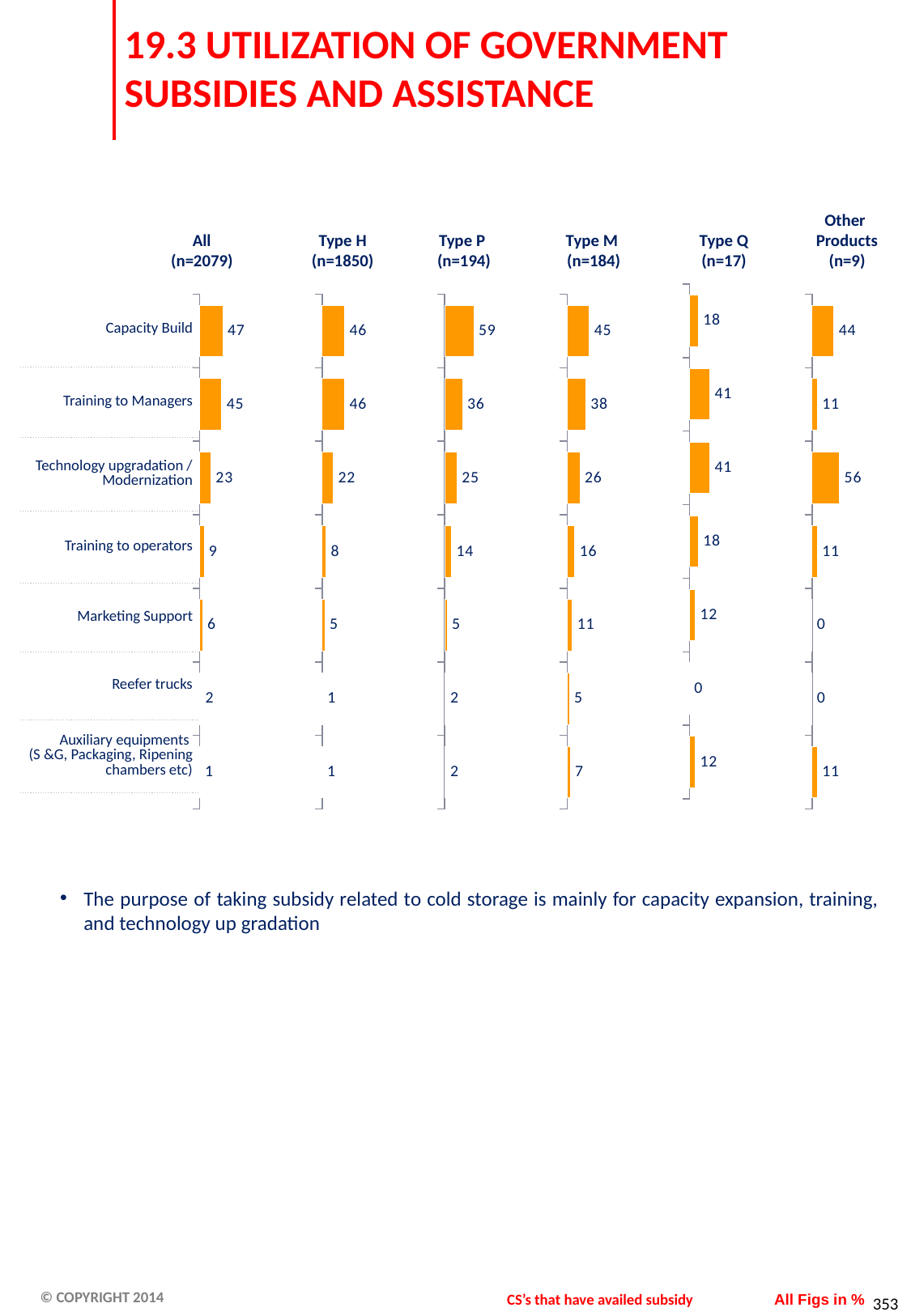
In the 'Type P (n=194)' chart, what is the difference between Capacity Build and Training to operators? 45 In the 'Type M (n=184)' chart, which category has the lowest value? Reefer trucks In the 'Type P (n=194)' chart, what is the value for Training to Managers? 36 In the 'Type H (n=1850)' chart, what is the difference between Capacity Build and Technology upgradation / Modernization? 24 In the 'Other Products (n=9)' chart, what is the value for Marketing Support? 0 In the 'All (n=2079)' chart, what is the value for Capacity Build? 47 In the 'Type M (n=184)' chart, what is the value for Auxiliary equipments (S &G, Packaging, Ripening chambers etc)? 7 What type of chart is used for the 'All (n=2079)' column? Bar chart In the 'Other Products (n=9)' chart, which category has the highest value? Technology upgradation / Modernization In the 'Type Q (n=17)' chart, which is larger: Training to Managers or Capacity Build? Training to Managers How many separate bar charts are shown on the slide? 6 How many categories are shown in each of the bar charts on the slide? 7